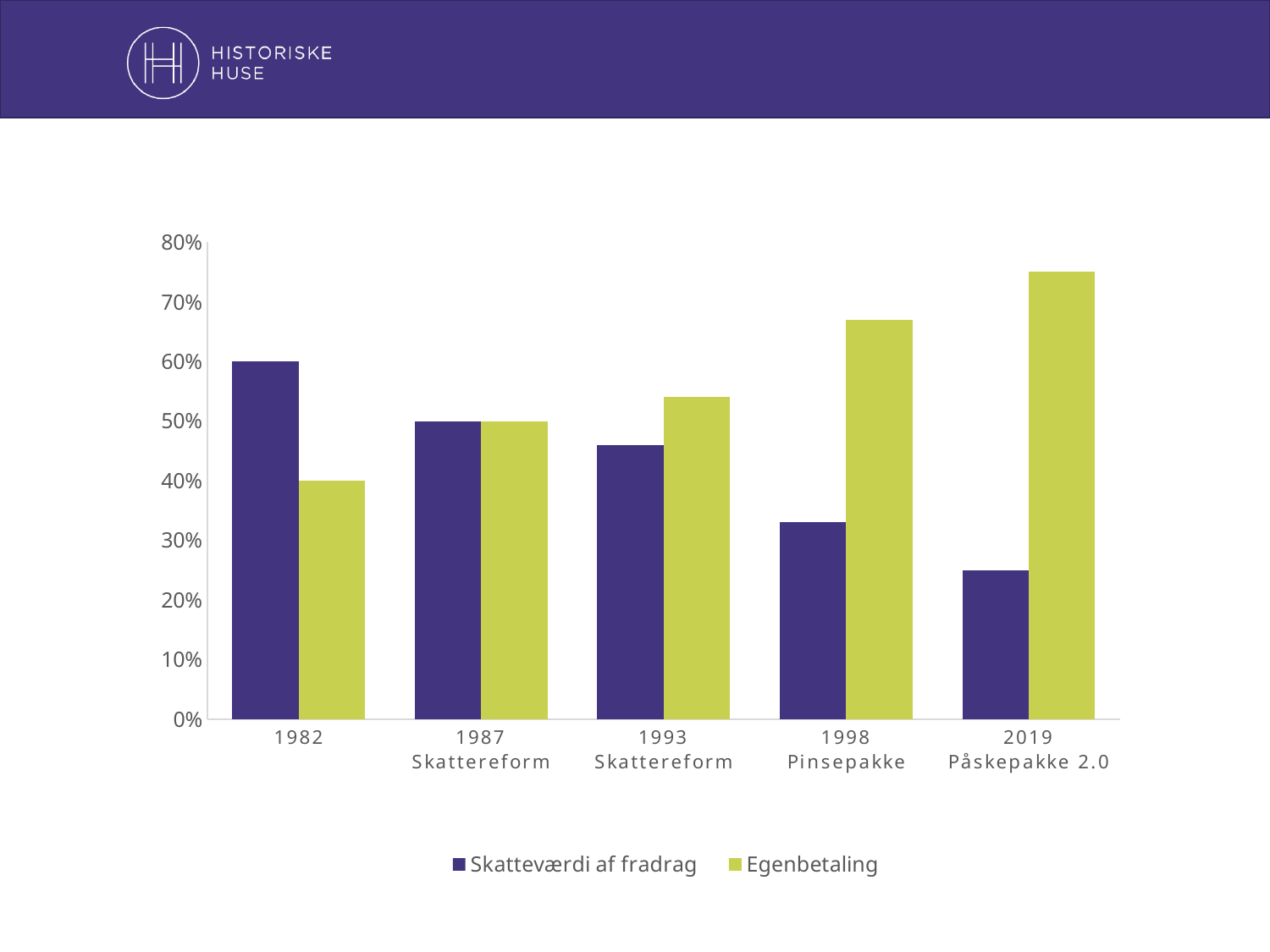
What kind of chart is shown on the slide? bar chart What is the value of Skatteværdi af fradrag for 1982? 60% Does the Skatteværdi af fradrag series rise or fall from 1982 to 2019? fall How many categories are shown along the x axis? 5 Which category has the highest Egenbetaling value? 2019 Påskepakke 2.0 For 1998 Pinsepakke, which is larger: Skatteværdi af fradrag or Egenbetaling? Egenbetaling Is the value of Egenbetaling for 1998 Pinsepakke greater or less than 60%? greater Which category has the lowest Skatteværdi af fradrag value? 2019 Påskepakke 2.0 Is the value of Egenbetaling for 2019 Påskepakke 2.0 greater or less than 70%? greater Is the value of Skatteværdi af fradrag for 2019 Påskepakke 2.0 greater or less than 30%? less What is the value of Egenbetaling for 1987 Skattereform? 50% How many series does the legend list? 2